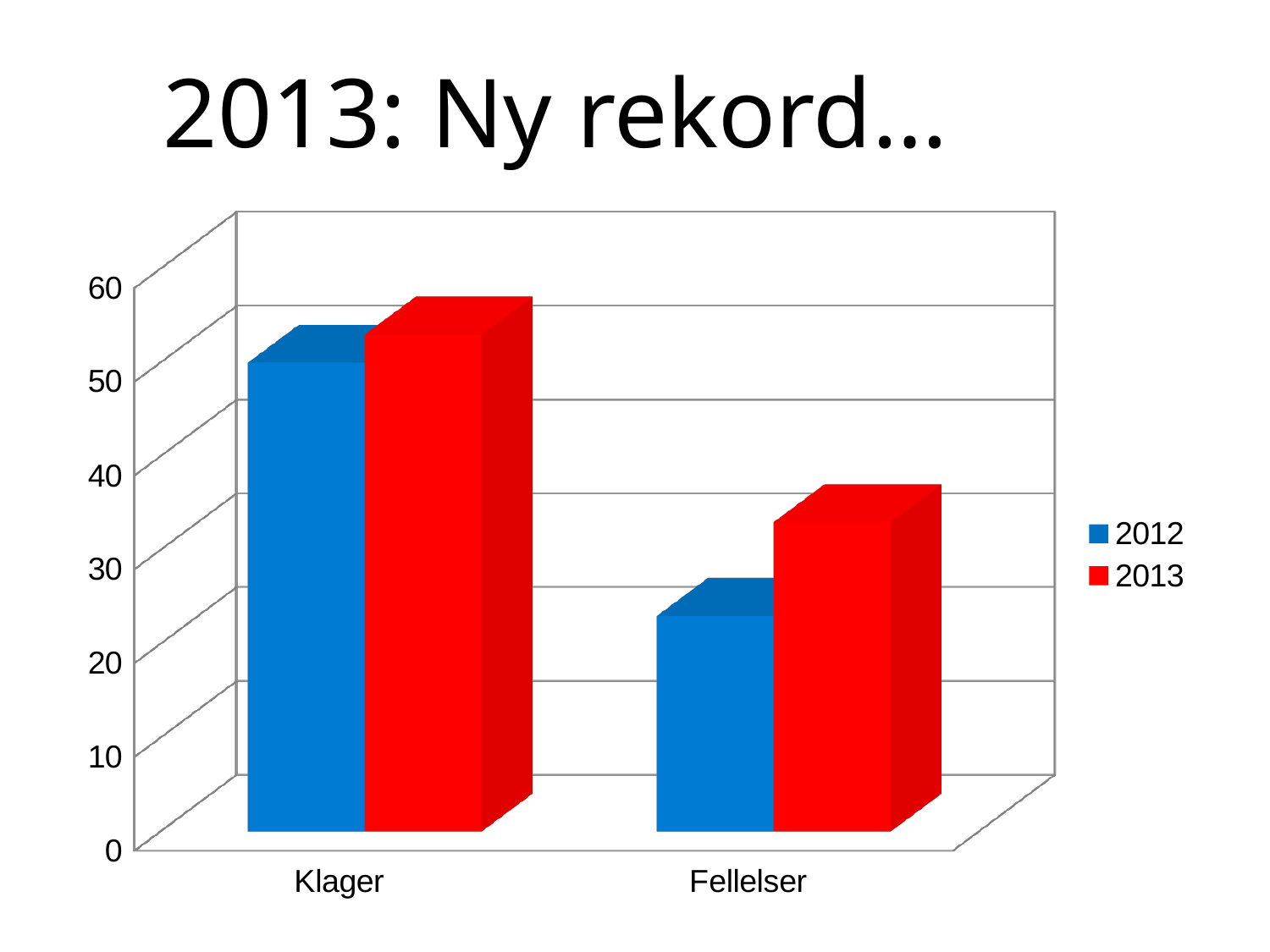
What kind of chart is shown on the slide? bar chart Which series are listed in the chart's legend? 2012 and 2013 For Fellelser, which series has the larger value, 2012 or 2013? 2013 For Klager, which series has the larger value, 2012 or 2013? 2013 How many series does the chart's legend list? 2 How many categories are shown on the x axis of the chart? 2 Which category has the lowest value for the 2012 series? Fellelser What is the title of the slide containing the chart? 2013: Ny rekord... Is the value for Fellelser in 2013 greater or less than 40? less Is the value for Fellelser in 2012 greater or less than 30? less Is the value for Klager in 2012 greater or less than 40? greater Which category has the highest value for the 2013 series? Klager